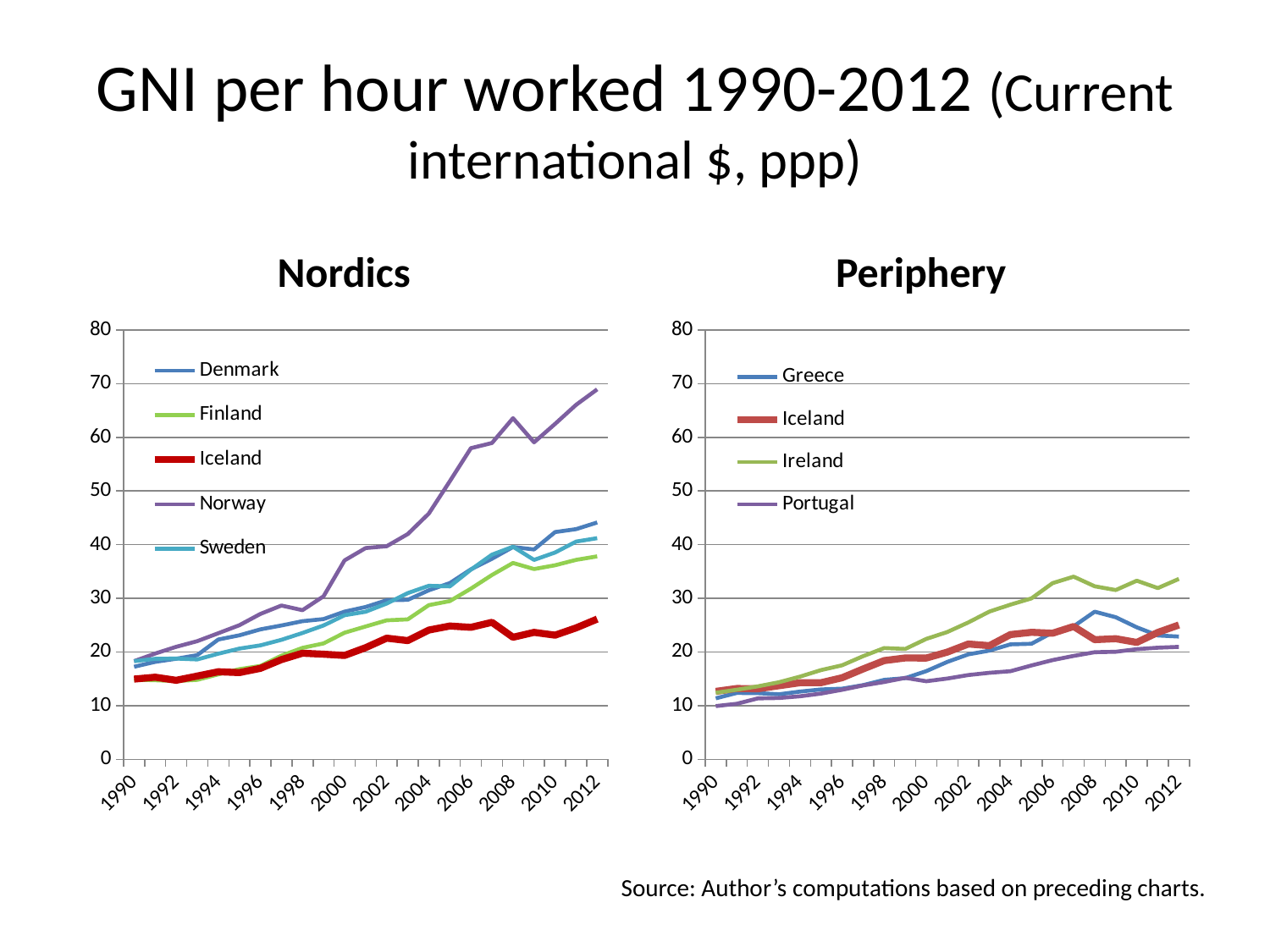
In the Nordics chart, is the value for Norway in 2012 greater or less than 60? greater In the Nordics chart, which is larger in 2012, the value for Denmark or the value for Iceland? Denmark In the Periphery chart, which country has the lowest value in 2012? Portugal In the Nordics chart, is the value for Iceland in 2012 greater or less than 30? less In the Periphery chart, is the value for Portugal in 2012 greater or less than 30? less In the Nordics chart, does the value for Norway generally rise or fall from 1990 to 2012? rise How many series does the legend of the Periphery chart list? 4 How many series does the legend of the Nordics chart list? 5 In the Nordics chart, which country has the lowest value in 2012? Iceland In the Nordics chart, which country has the highest value in 2012? Norway What kind of chart is the Nordics chart? line chart In the Periphery chart, which country has the highest value in 2012? Ireland